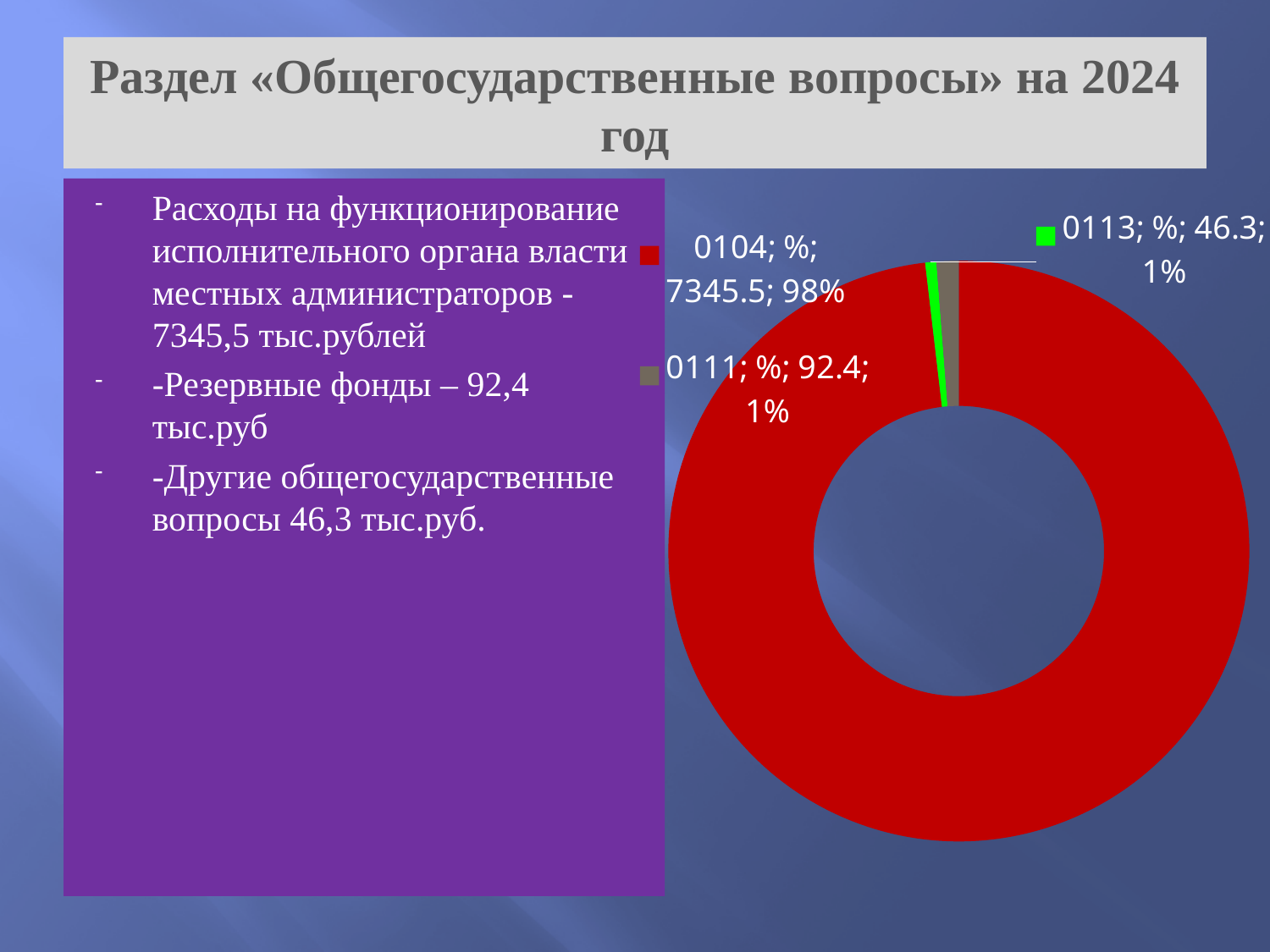
What is the value for category 0113? 46.3 What is the value for category 0111? 92.4 What colour is the slice for category 0113? Green What is the value for category 0104? 7345.5 What kind of chart is shown on the slide? Doughnut (pie) chart Which category has the largest value? 0104 Which is larger, the value for 0111 or the value for 0113? 0111 Which category has the smallest value? 0113 What is the difference between the values for 0111 and 0113? 46.1 What share of the chart does category 0111 represent? 1% How many categories does the chart show? 3 What share of the chart does category 0104 represent? 98%